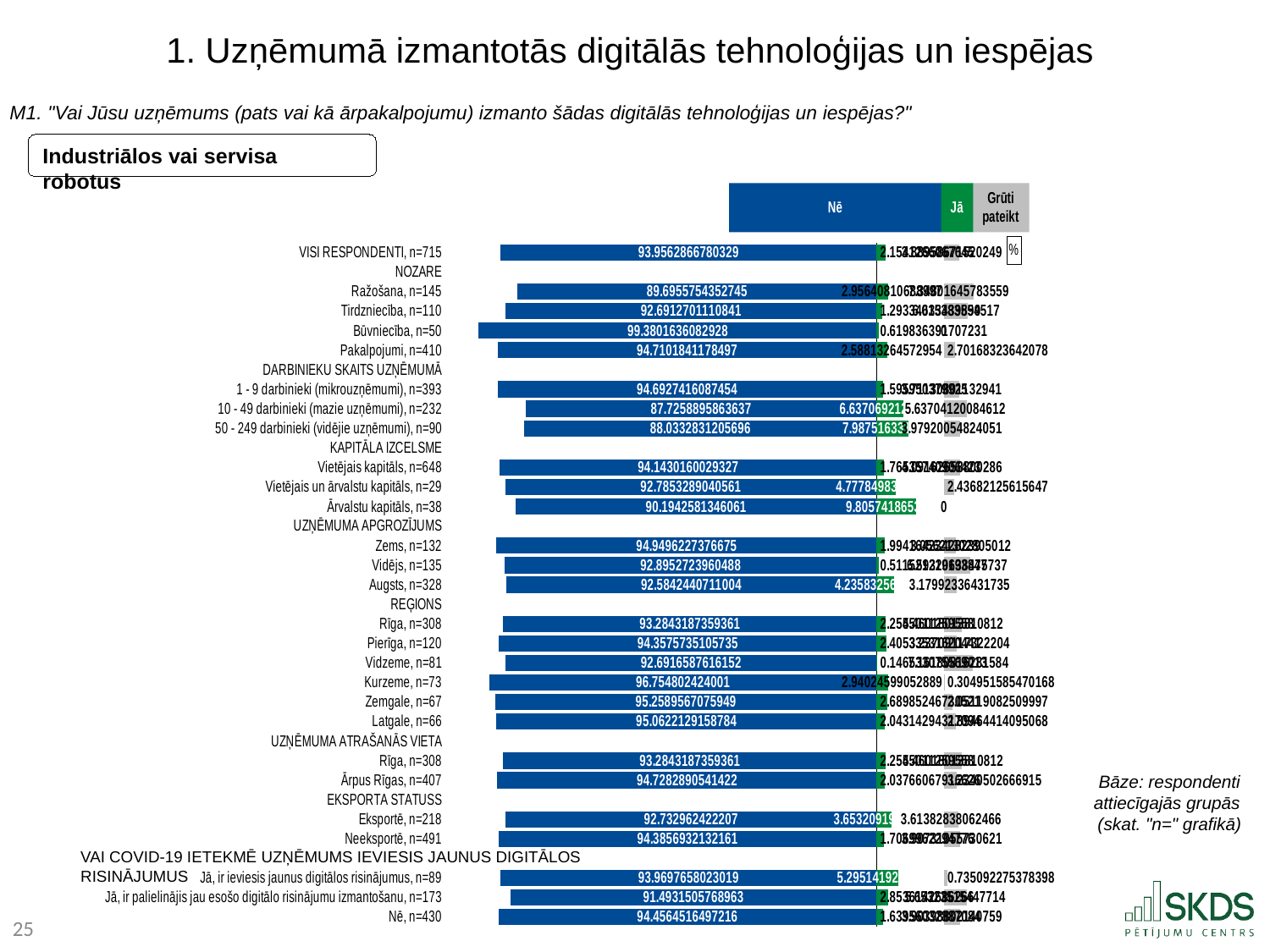
What is the difference between the "Nē" values for Būvniecība, n=50 and Ražošana, n=145? 9.6845881730183 How many regions are listed under REĢIONS? 6 What is the "Nē" value for VISI RESPONDENTI, n=715? 93.9562866780329 What is the "Nē" value for Kurzeme, n=73? 96.754802424001 Which group has the highest "Nē" value? Būvniecība, n=50 What is the "Nē" value for Būvniecība, n=50? 99.3801636082928 Which group has the lowest "Nē" value? 10 - 49 darbinieki (mazie uzņēmumi), n=232 How many series does the legend list? 3 Which has a larger "Nē" value: Eksportē, n=218 or Neeksportē, n=491? Neeksportē, n=491 What kind of chart is shown on the slide? Bar chart What is the "Grūti pateikt" value for Ārvalstu kapitāls, n=38? 0 What is the "Nē" value for 10 - 49 darbinieki (mazie uzņēmumi), n=232? 87.7258895863637